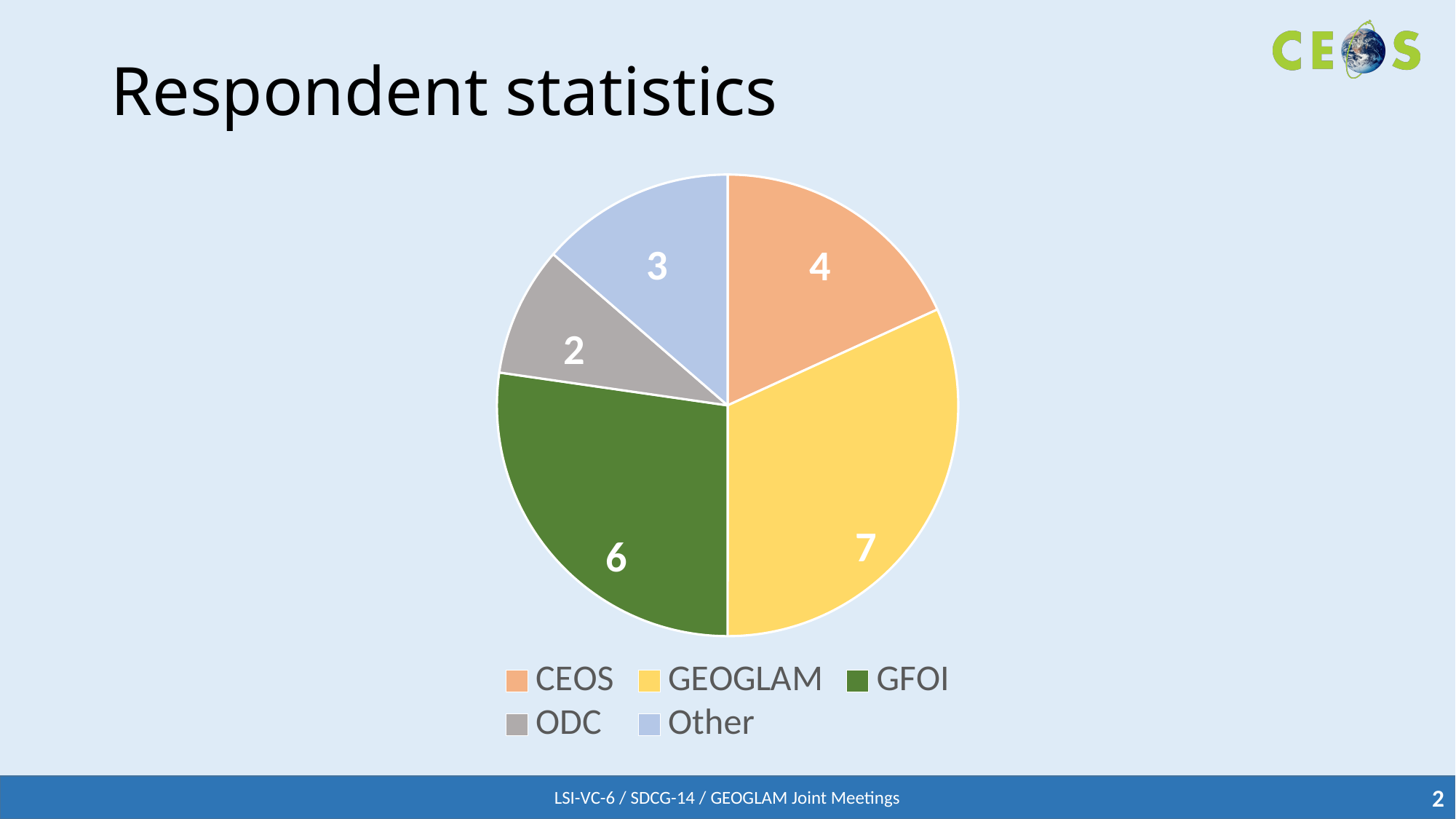
What is the total of all slices in the pie chart? 22 What is the title of the slide containing the chart? Respondent statistics How many categories does the pie chart have? 5 What type of chart is shown on the slide? pie chart Which category has the smallest slice? ODC What is the value for CEOS? 4 Which category has the largest slice? GEOGLAM What is the value for ODC? 2 What is the value for GEOGLAM? 7 What is the difference between the GEOGLAM and GFOI values? 1 Which is larger, the value for CEOS or the value for Other? CEOS What is the value for Other? 3